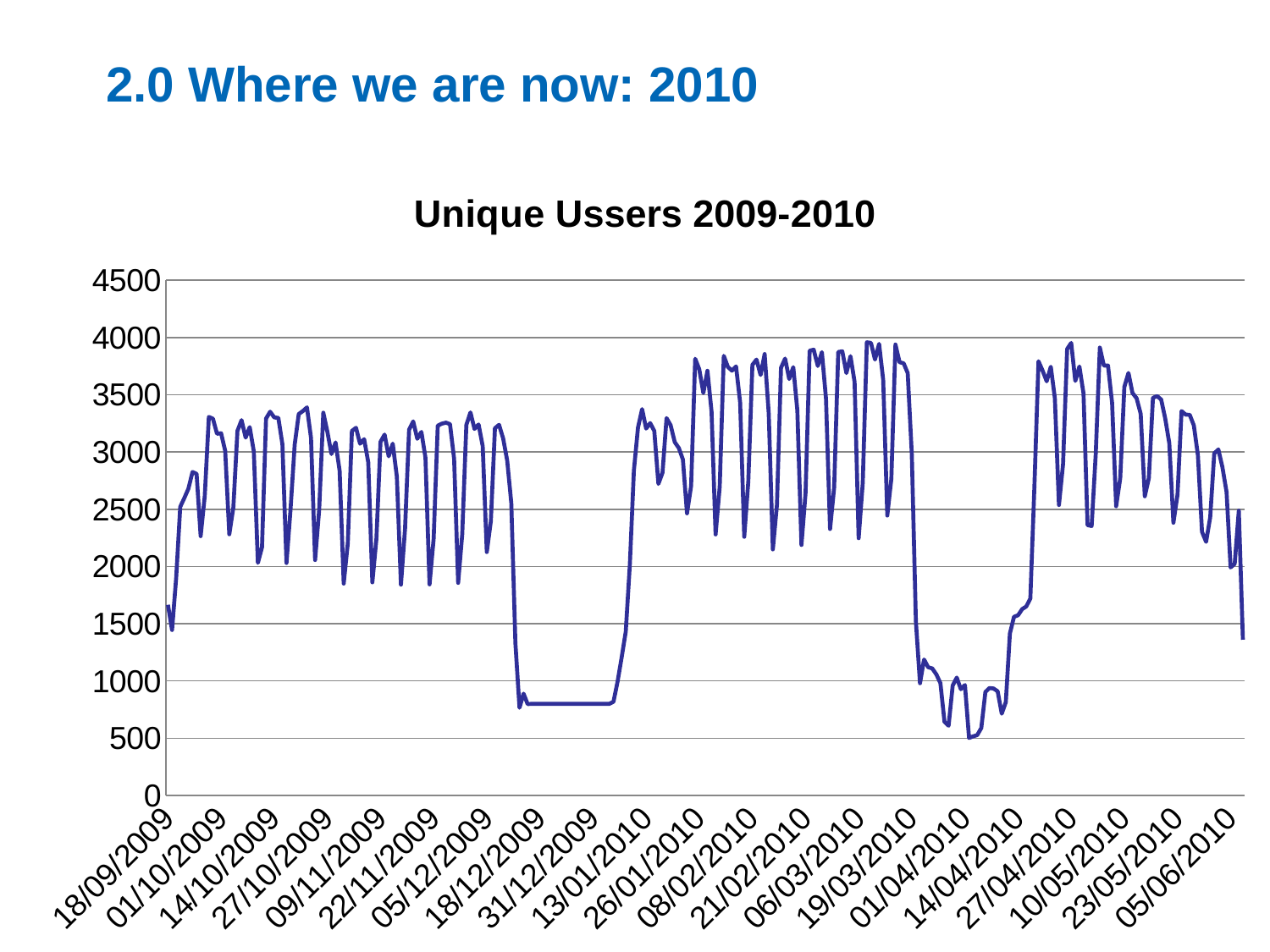
Is the value of the line at 31/12/2009 greater or less than 1000? less Which is larger: the value of the line at 31/12/2009 or the value at 19/03/2010? 19/03/2010 Is the highest peak of the line near 19/03/2010 greater or less than 3500? greater In which month does the line reach its lowest value? April 2010 What kind of chart is shown on the slide? line chart What is the highest value shown on the y axis? 4500 Is the value of the line at 18/12/2009 greater or less than 1500? less What is the title of the chart? Unique Ussers 2009-2010 Between 27/04/2010 and 05/06/2010, do the peaks of the line generally rise or fall? fall Which is higher: the peaks of the line in October 2009 or the peaks in March 2010? March 2010